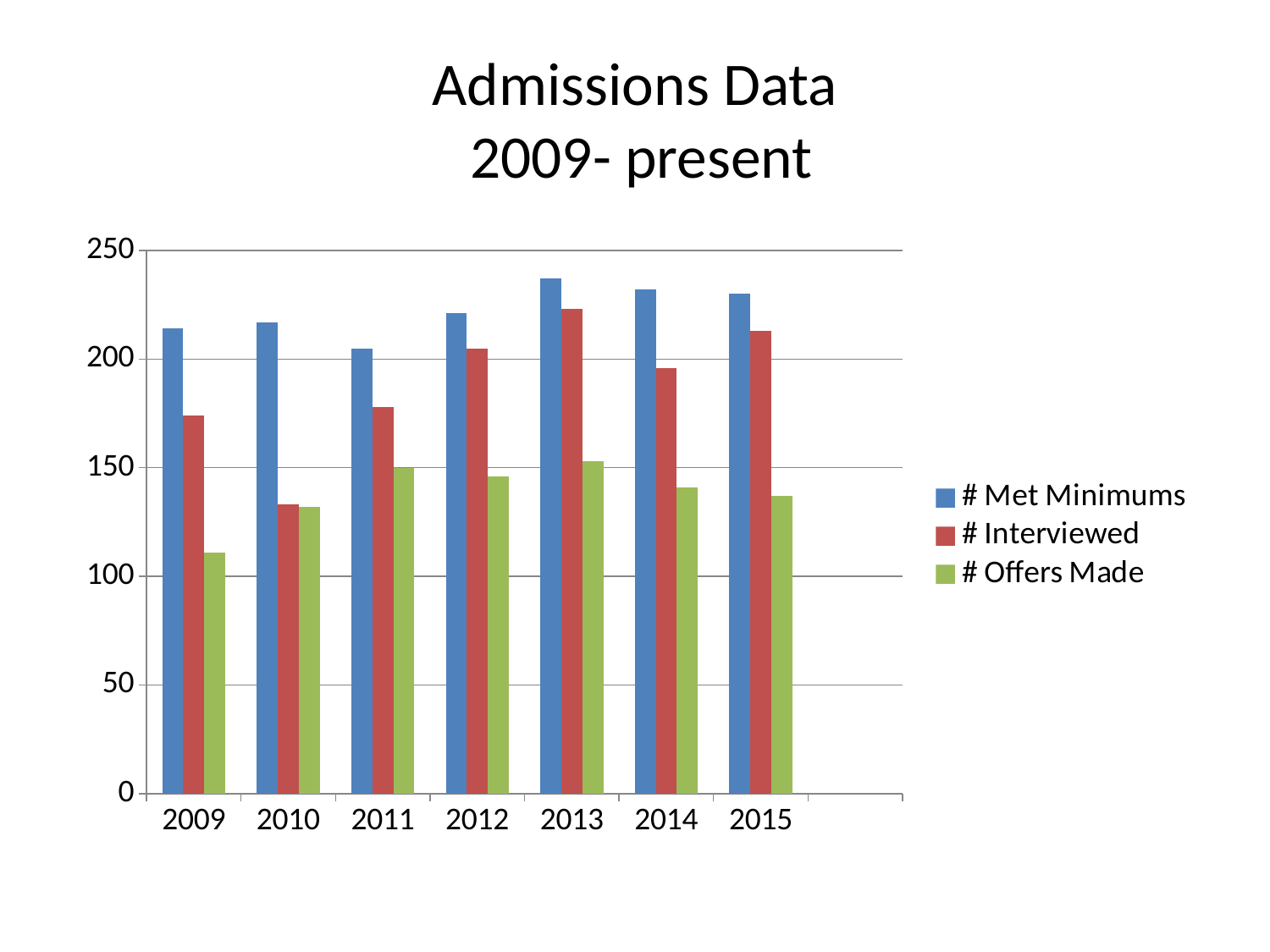
In which year is # Interviewed lowest? 2010 In which year is # Offers Made lowest? 2009 How many years are shown on the x axis? 7 How many series does the legend list? 3 What kind of chart is shown on the slide? bar chart Is the value for # Interviewed in 2010 greater or less than 150? less What is the title of the chart? Admissions Data 2009- present Which series is shown in green? # Offers Made Is the value for # Met Minimums in 2013 greater or less than 200? greater In which year is # Interviewed highest? 2013 Which is larger in 2009, # Met Minimums or # Interviewed? # Met Minimums Does # Interviewed rise or fall from 2010 to 2013? rise